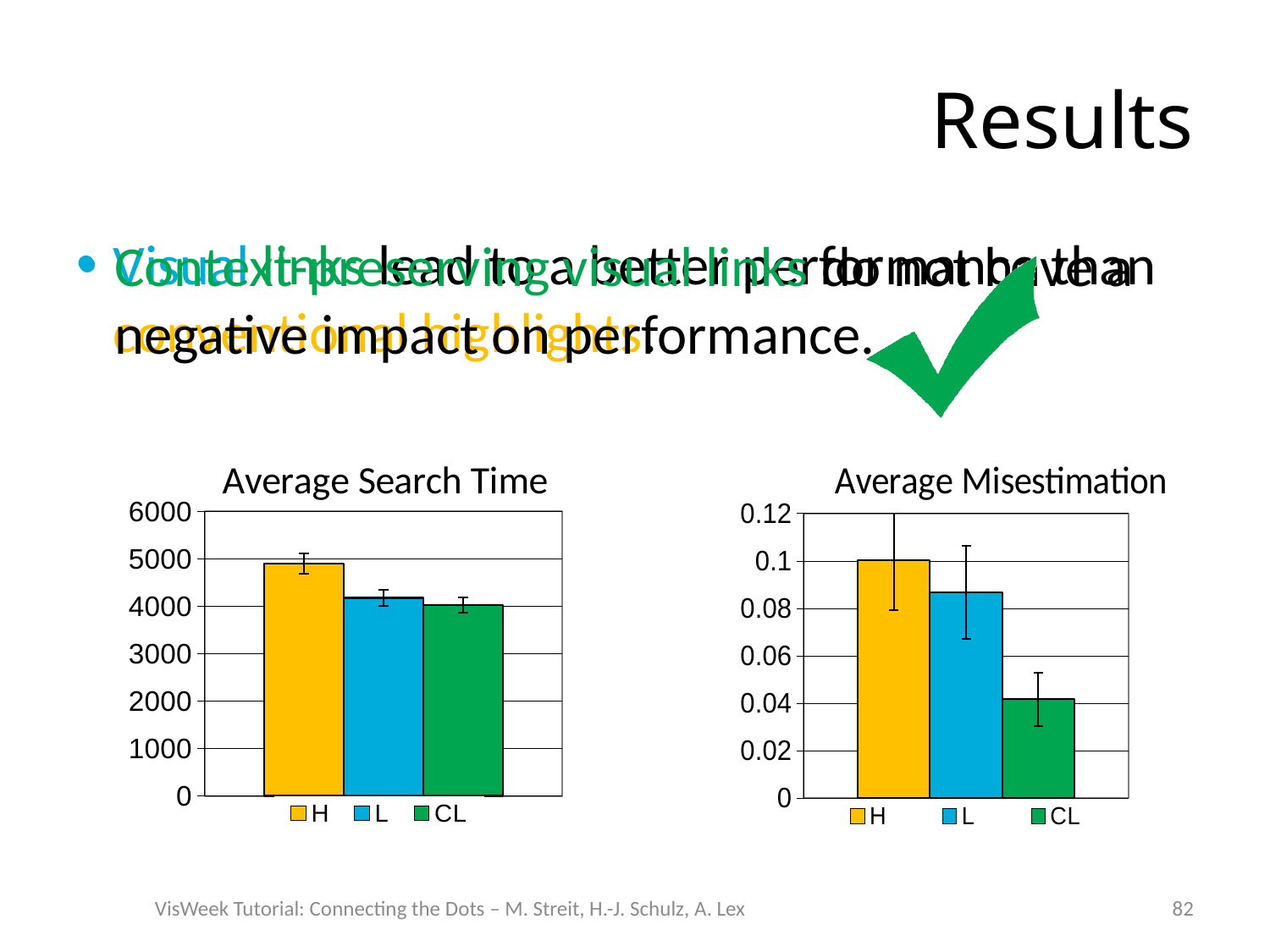
In the Average Search Time chart, is the value for CL greater or less than 5000? less What type of chart is the Average Search Time chart? bar chart In the Average Misestimation chart, which is larger, the value for L or the value for CL? L In the Average Misestimation chart, do the values rise or fall from left to right? fall In the Average Search Time chart, is the value for H greater or less than 4000? greater In the Average Misestimation chart, is the value for L greater or less than 0.06? greater In the Average Misestimation chart, which category has the highest value? H In the Average Misestimation chart, which category has the lowest value? CL In the Average Search Time chart, which category has the highest value? H In the Average Search Time chart, which is larger, the value for H or the value for L? H How many series does the legend of the Average Misestimation chart list? 3